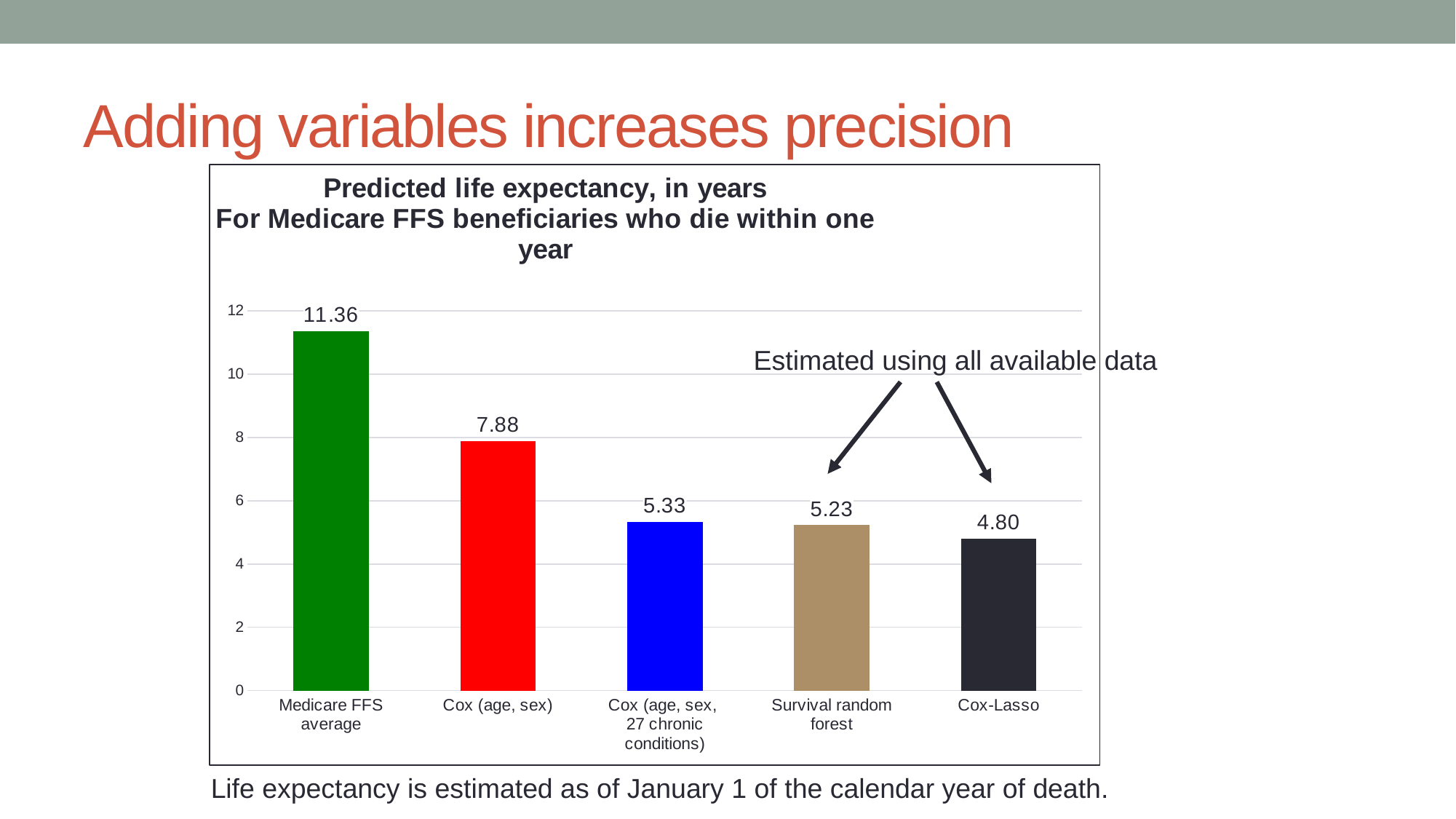
What is the predicted life expectancy for the Medicare FFS average? 11.36 What is the predicted life expectancy for Cox-Lasso? 4.80 What is the difference between the Medicare FFS average and the Cox (age, sex) value? 3.48 Which is larger, the value for Cox (age, sex) or the value for Survival random forest? Cox (age, sex) Which category has the lowest predicted life expectancy? Cox-Lasso What is the difference between Cox (age, sex, 27 chronic conditions) and Cox-Lasso? 0.53 What is the predicted life expectancy for Survival random forest? 5.23 Do the values rise or fall moving from left to right along the x axis? Fall Which category has the highest predicted life expectancy? Medicare FFS average What kind of chart is shown on the slide? Bar chart How many categories are shown on the x axis? 5 What is the predicted life expectancy for Cox (age, sex)? 7.88